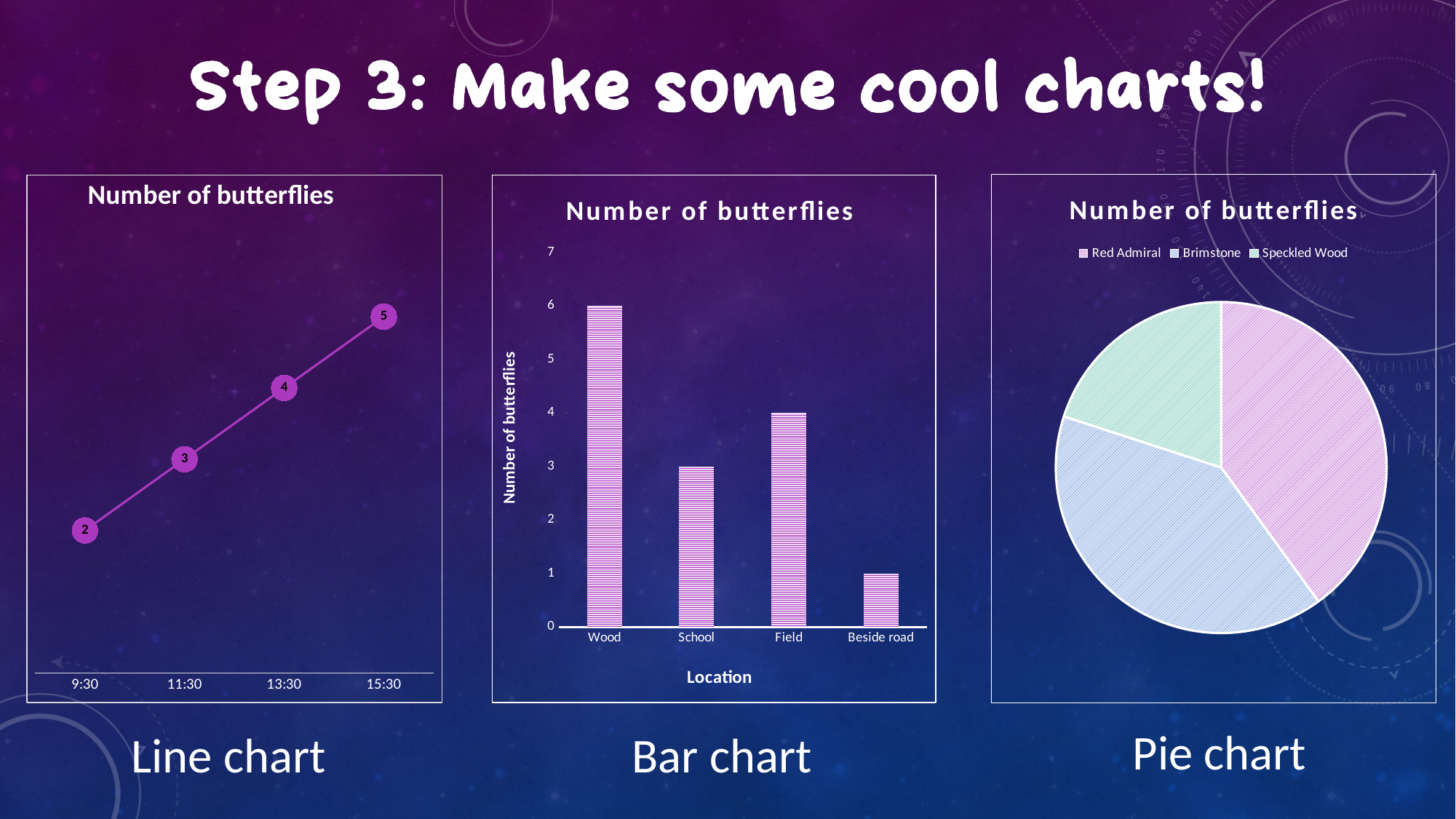
On the line chart on the left, do the values rise or fall from 9:30 to 15:30? rise On the line chart on the left, at which time is the number of butterflies lowest? 9:30 On the line chart on the left, how many data points are plotted? 4 On the bar chart in the middle, what is the difference between the values for Wood and School? 3 On the bar chart in the middle, which location has the highest number of butterflies? Wood On the pie chart on the right, how many series does the legend list? 3 On the bar chart in the middle, which has more butterflies, School or Field? Field On the line chart on the left, what is the difference between the values at 15:30 and 9:30? 3 On the bar chart in the middle, what is the number of butterflies for Field? 4 On the pie chart on the right, which butterfly has the smallest slice? Speckled Wood On the bar chart in the middle, which location has the lowest number of butterflies? Beside road On the line chart on the left, what is the number of butterflies at 13:30? 4